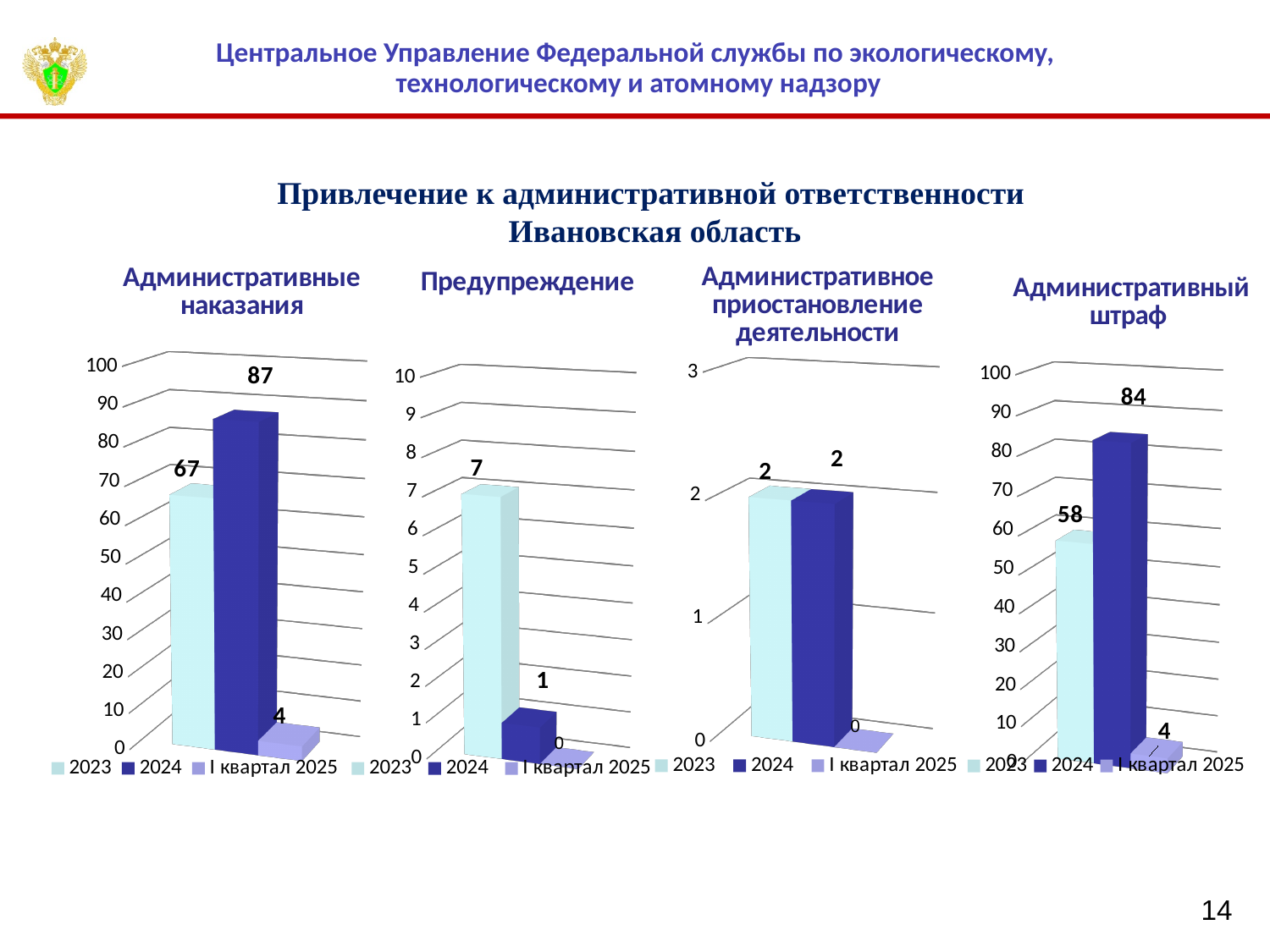
In the 'Административные наказания' chart, what is the difference between the 2024 and 2023 values? 20 In the 'Административное приостановление деятельности' chart, what is the value for 2024? 2 In the 'Административное приостановление деятельности' chart, what is the value for I квартал 2025? 0 What kind of chart is the 'Административный штраф' chart? Bar chart In the 'Предупреждение' chart, what is the value for 2023? 7 In the 'Административные наказания' chart, what is the value for 2023? 67 In the 'Административный штраф' chart, what is the difference between the 2024 and 2023 values? 26 In the 'Административный штраф' chart, which series has the highest value? 2024 In the 'Административный штраф' chart, what is the value for 2023? 58 In the 'Предупреждение' chart, which series has the lowest value? I квартал 2025 How many series does the legend of the 'Предупреждение' chart list? 3 In the 'Административные наказания' chart, what is the value for 2024? 87